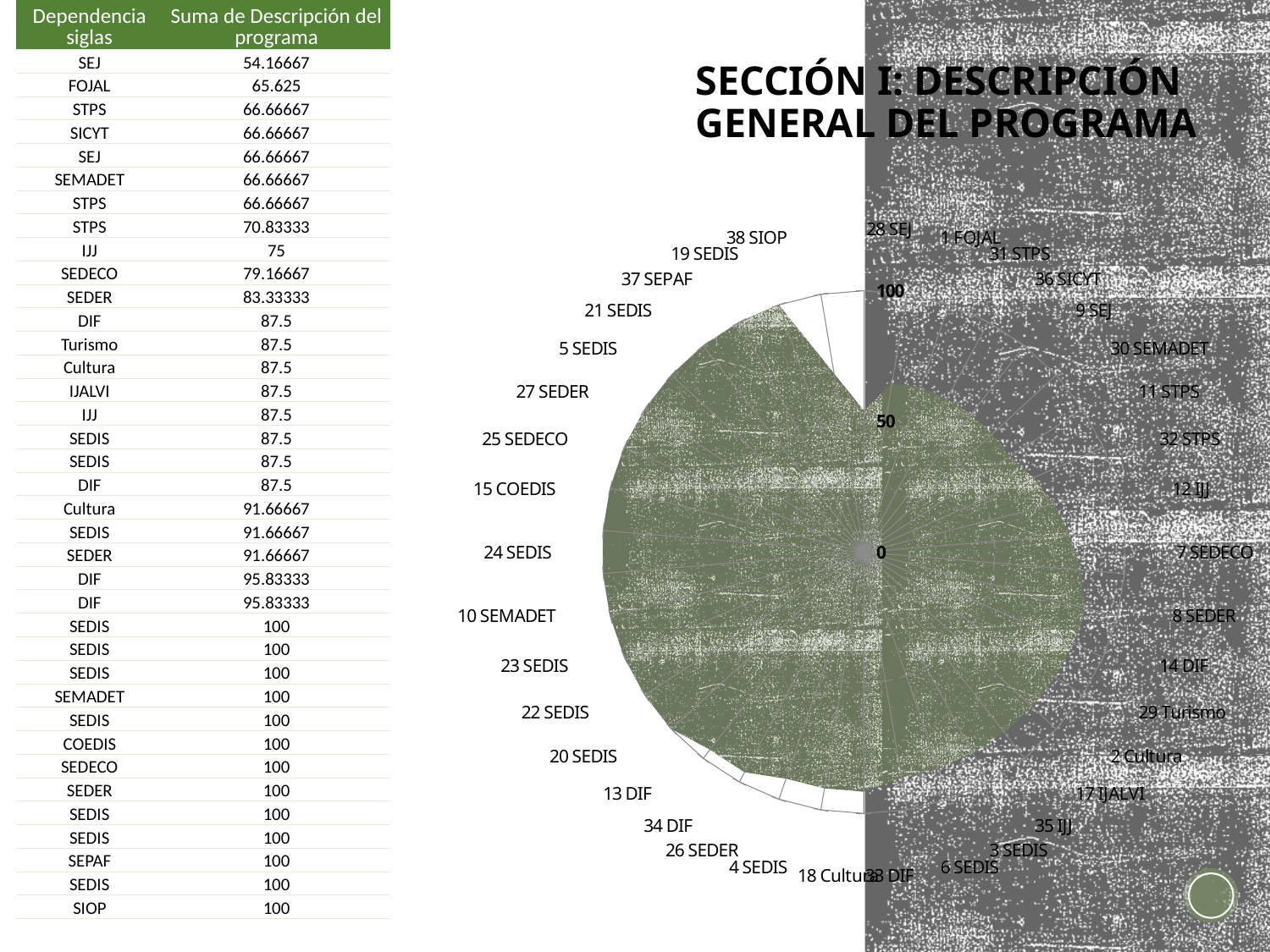
Is the value for 15 COEDIS on the radar chart greater or less than 50? greater Is the value for 24 SEDIS on the radar chart greater or less than 50? greater Is the value for 28 SEJ on the radar chart greater or less than 100? less According to the table on the left, which dependency has the lowest value? SEJ According to the table on the left, what is the value for FOJAL? 65.625 What tick values are printed on the radar chart's axis? 0, 50, 100 According to the table on the left, what is the value for SIOP? 100 What is the highest value shown on the radar chart's axis? 100 How many categories are plotted around the radar chart? 37 What kind of chart is shown on the slide? radar chart